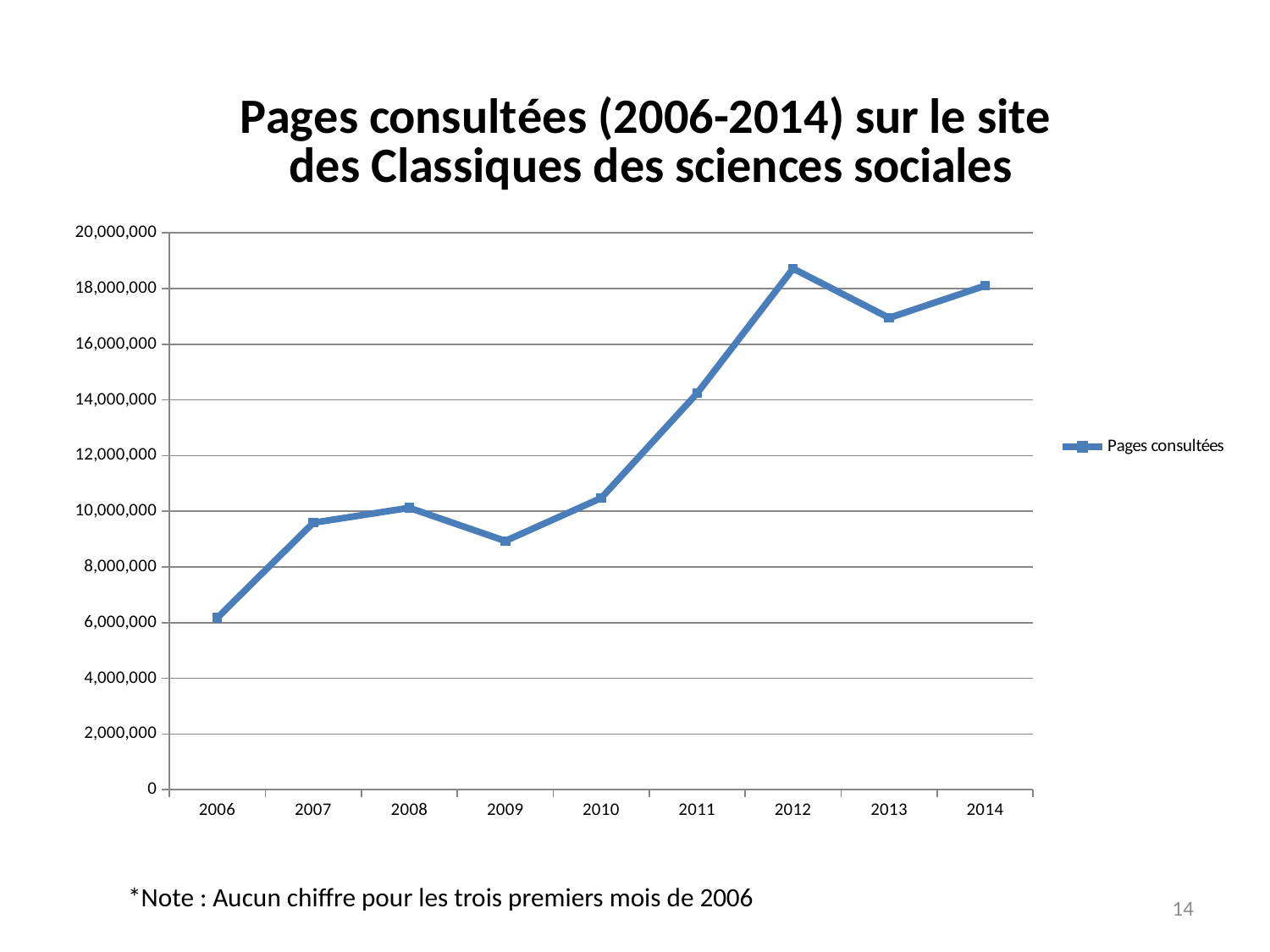
Which year has more pages consultées, 2012 or 2013? 2012 Do the values generally rise or fall from 2009 to 2012? rise What is the name of the series shown in the legend? Pages consultées Is the value for 2011 greater or less than 12,000,000? greater Which year has the highest number of pages consultées? 2012 Which year has the lowest number of pages consultées? 2006 What kind of chart is shown on the slide? line chart Is the value for 2009 greater or less than 10,000,000? less How many series does the legend list? 1 How many years are plotted on the x axis of the chart? 9 Is the value for 2006 greater or less than 8,000,000? less